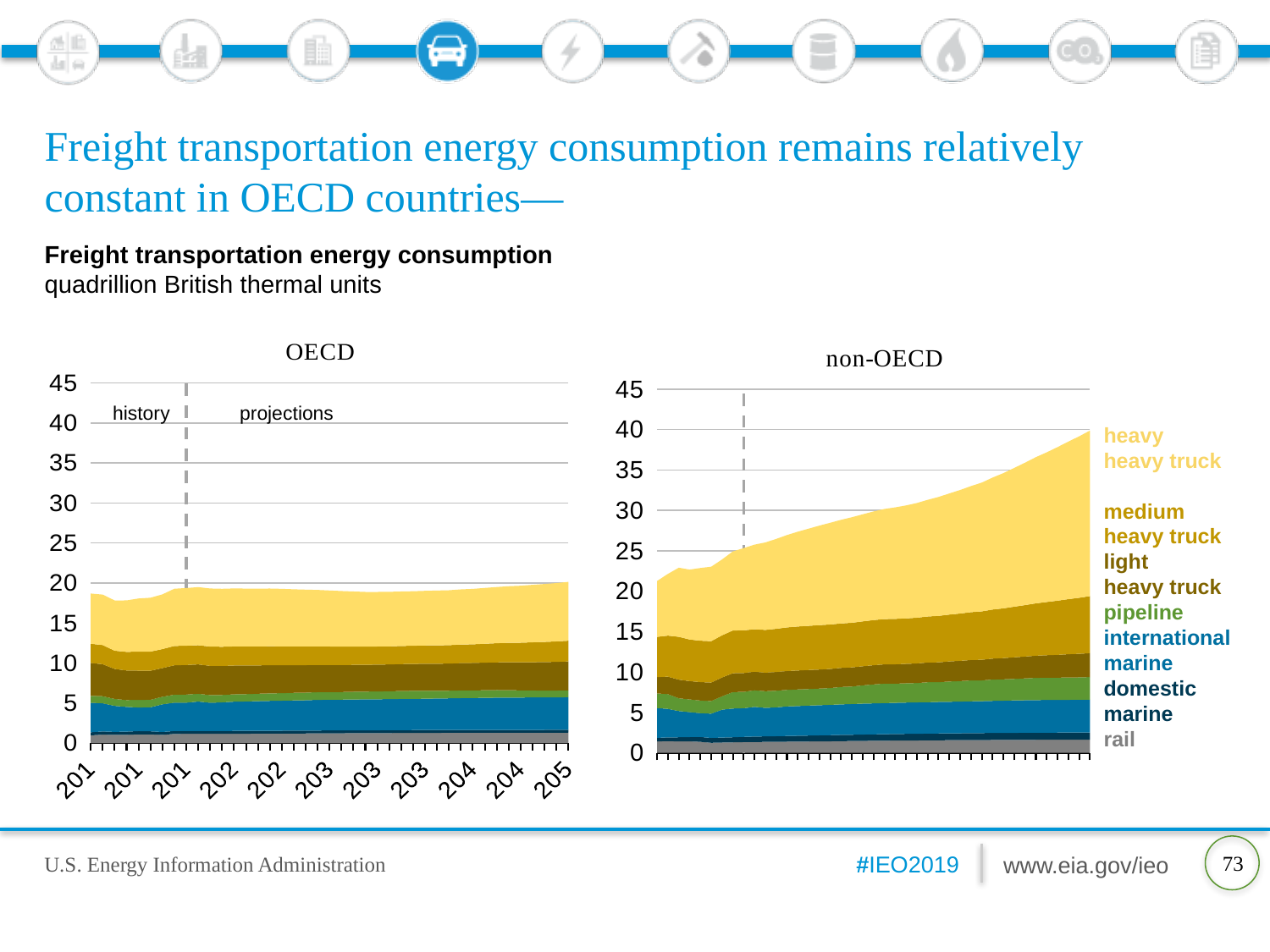
In the non-OECD chart, is the total freight transportation energy consumption at the end of the projection period greater or less than 35? greater In the non-OECD chart, is the total freight transportation energy consumption at the end of the projection period greater or less than 45? less In the non-OECD chart, do total values rise or fall over the projection period? rise In the OECD chart, which series accounts for the largest share of energy consumption at the end of the projection period? heavy heavy truck What is the title of the chart on the right side of the slide? non-OECD Which chart shows the larger total freight transportation energy consumption at the end of the projection period, OECD or non-OECD? non-OECD What kind of chart is the OECD chart? stacked area chart How many series does the legend list for the freight transportation energy consumption charts? 7 In the non-OECD chart, which series accounts for the largest share of energy consumption at the end of the projection period? heavy heavy truck In the OECD chart, is the total freight transportation energy consumption at the end of the projection period greater or less than 25? less What unit of measurement is used for the freight transportation energy consumption charts? quadrillion British thermal units